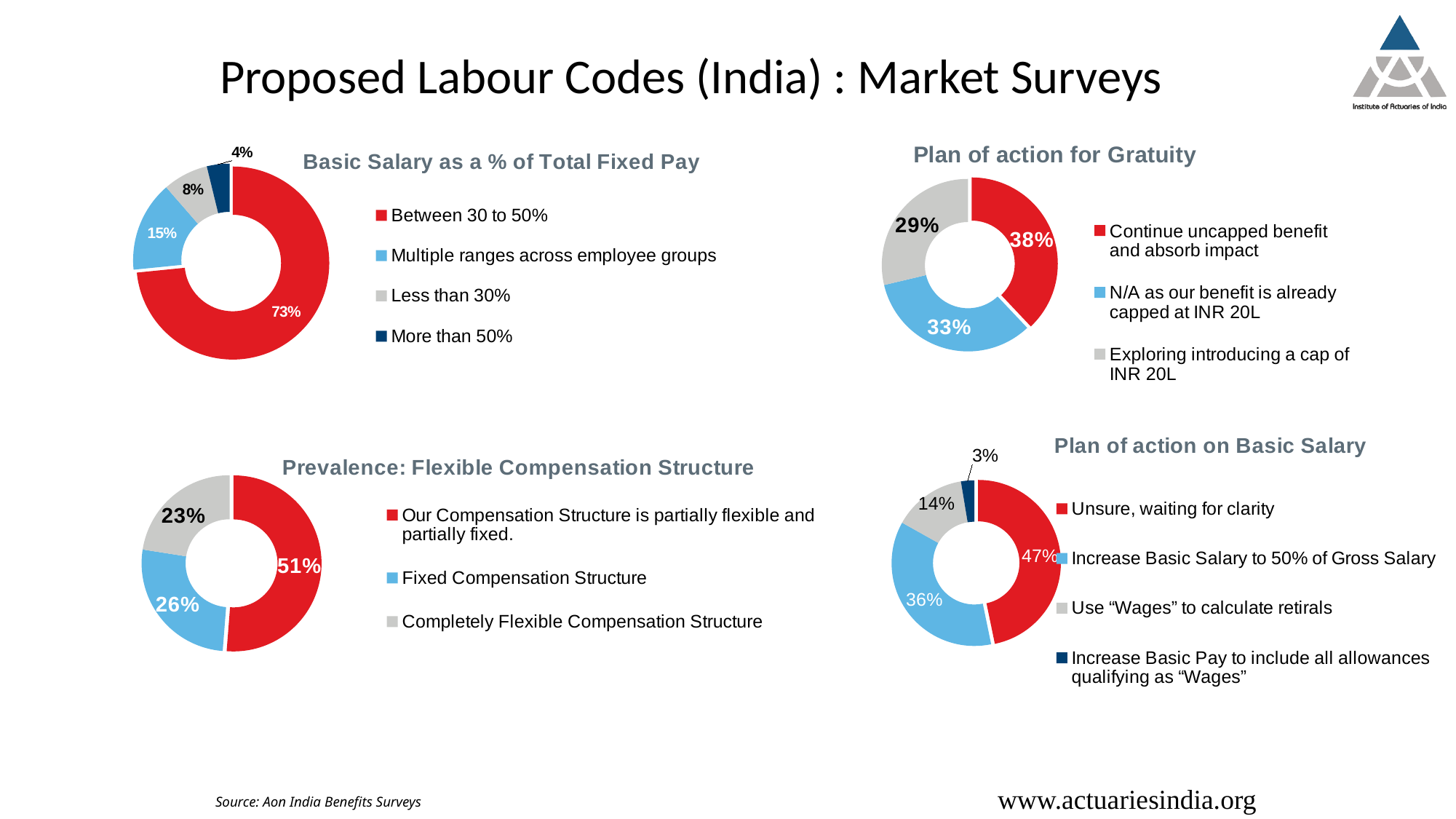
In the 'Basic Salary as a % of Total Fixed Pay' chart, which category has the smallest share? More than 50% In the 'Plan of action for Gratuity' chart, what share is 'N/A as our benefit is already capped at INR 20L'? 33% In the 'Basic Salary as a % of Total Fixed Pay' chart, what share is 'Between 30 to 50%'? 73% In the 'Basic Salary as a % of Total Fixed Pay' chart, what is the difference between 'Multiple ranges across employee groups' and 'Less than 30%'? 7% In the 'Prevalence: Flexible Compensation Structure' chart, what share is 'Fixed Compensation Structure'? 26% What kind of chart is the 'Prevalence: Flexible Compensation Structure' chart? Doughnut (pie) chart In the 'Plan of action for Gratuity' chart, which category has the largest share? Continue uncapped benefit and absorb impact How many categories does the 'Plan of action on Basic Salary' chart's legend list? 4 In the 'Plan of action on Basic Salary' chart, what is the difference between 'Unsure, waiting for clarity' and 'Increase Basic Salary to 50% of Gross Salary'? 11% How many categories does the 'Plan of action for Gratuity' chart show? 3 In the 'Prevalence: Flexible Compensation Structure' chart, which is larger: 'Fixed Compensation Structure' or 'Completely Flexible Compensation Structure'? Fixed Compensation Structure In the 'Plan of action on Basic Salary' chart, what share is 'Use "Wages" to calculate retirals'? 14%